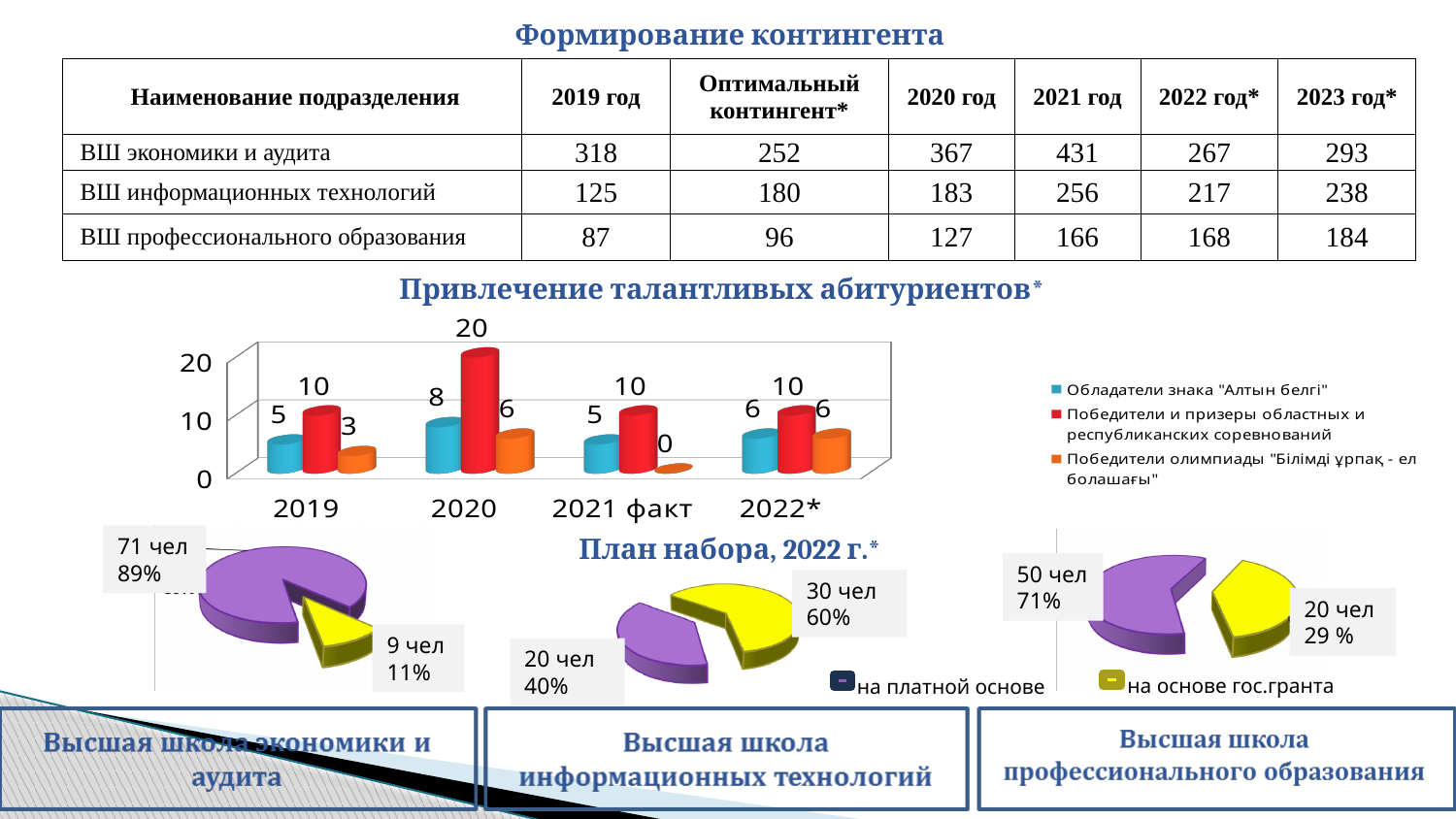
In the bar chart 'Привлечение талантливых абитуриентов', how many categories are shown on the x axis? 4 In the bar chart 'Привлечение талантливых абитуриентов', what is the value for 'Победители и призеры областных и республиканских соревнований' in 2020? 20 What kind of chart is 'Привлечение талантливых абитуриентов'? bar chart In the bar chart 'Привлечение талантливых абитуриентов', what is the value for 'Обладатели знака "Алтын белгі"' in 2019? 5 In the pie chart for 'Высшая школа информационных технологий' (План набора, 2022 г.), how many people are 'на основе гос.гранта'? 30 чел In the pie chart for 'Высшая школа профессионального образования' (План набора, 2022 г.), which is larger: 'на платной основе' or 'на основе гос.гранта'? на платной основе In the pie chart for 'Высшая школа профессионального образования' (План набора, 2022 г.), what share is 'на основе гос.гранта'? 29 % In the pie chart for 'Высшая школа экономики и аудита' (План набора, 2022 г.), what share is 'на платной основе'? 89% In the bar chart 'Привлечение талантливых абитуриентов', what is the difference between the 'Обладатели знака "Алтын белгі"' values for 2020 and 2019? 3 In the bar chart 'Привлечение талантливых абитуриентов', how many series does the legend list? 3 In the bar chart 'Привлечение талантливых абитуриентов', in which year is the value for 'Победители и призеры областных и республиканских соревнований' highest? 2020 In the bar chart 'Привлечение талантливых абитуриентов', what is the value for 'Победители олимпиады "Білімді ұрпақ - ел болашағы"' in 2021 факт? 0